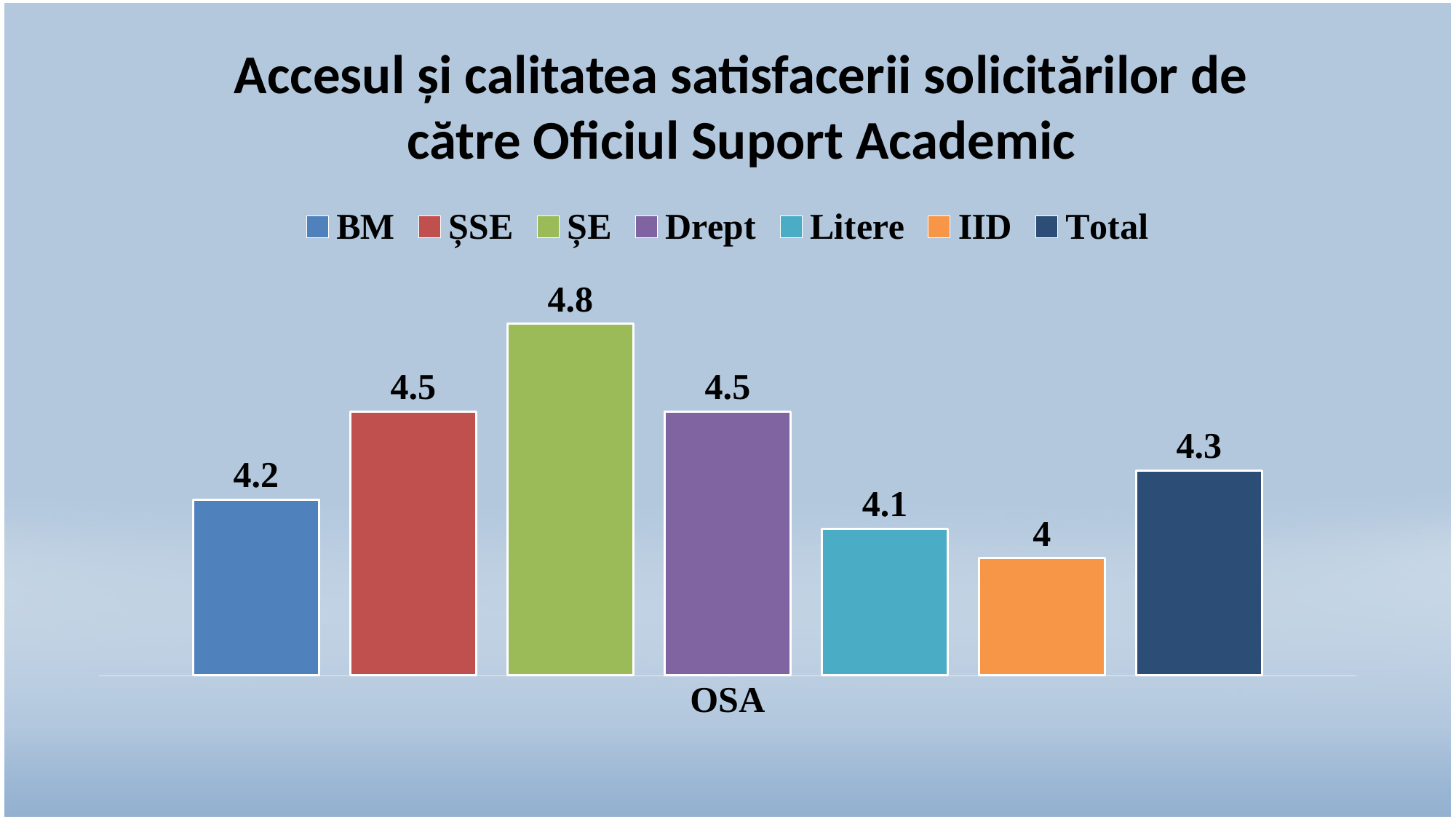
How many series does the legend list? 7 What is the difference between the values for ȘSE and Litere? 0.4 Which is larger, the value for Drept or the value for Litere? Drept What is the value for Total? 4.3 Which series has the lowest value? IID What is the value for BM? 4.2 Which series has the highest value? ȘE What is the category label shown on the x axis? OSA What is the value for IID? 4 What kind of chart is shown? Bar chart What is the value for ȘE? 4.8 What is the difference between the values for ȘE and IID? 0.8